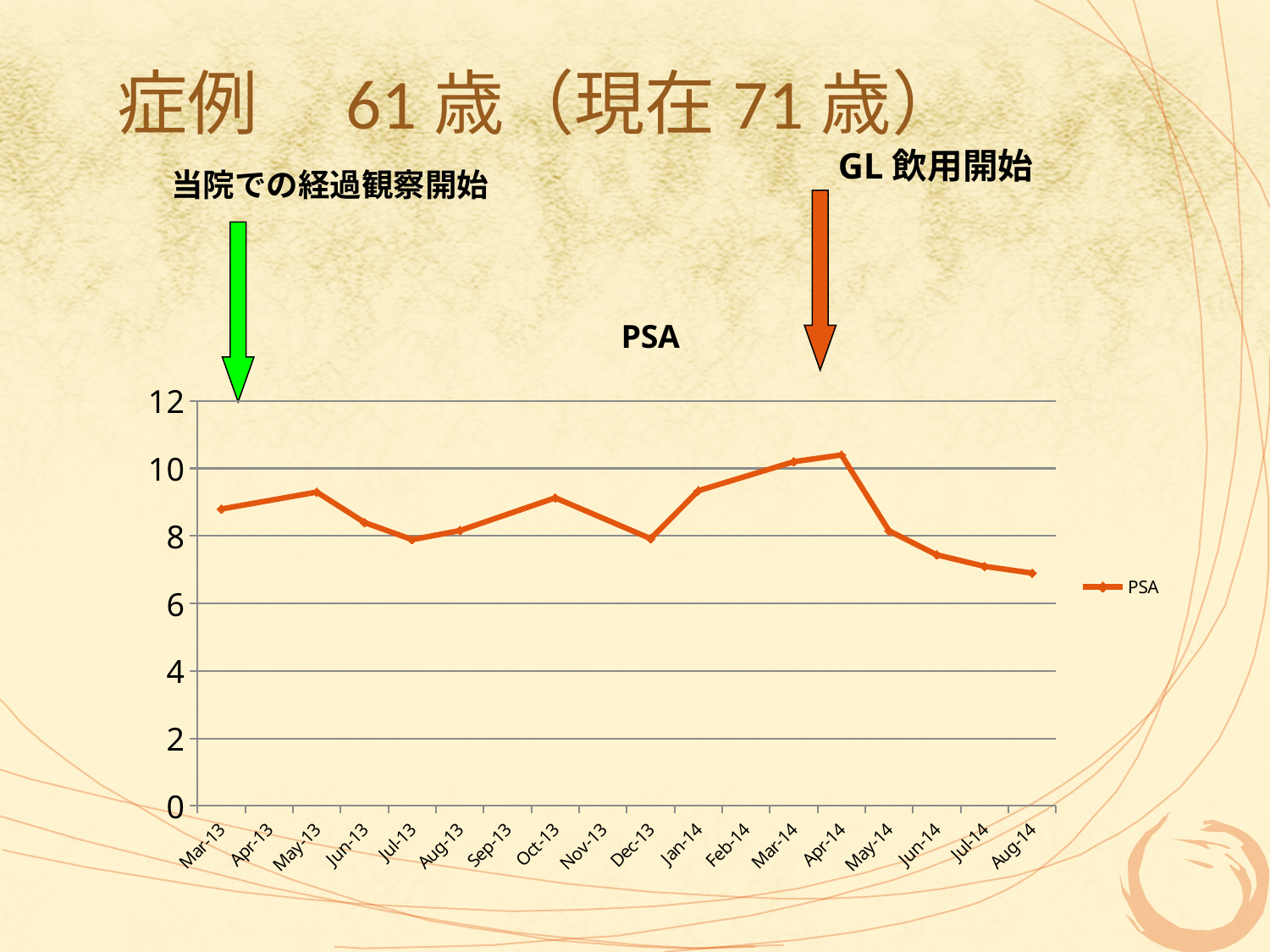
How many series does the legend list? 1 Is the PSA value for Apr-14 greater or less than 10? greater Is the PSA value for Aug-14 greater or less than 8? less Which has the larger PSA value, Jun-13 or Jun-14? Jun-13 What is the title of the chart? PSA How many months are plotted along the x axis? 18 In which month is the PSA value highest? Apr-14 What kind of chart is shown on the slide? line chart Is the PSA value for Jun-14 greater or less than 8? less Which has the larger PSA value, Apr-14 or Aug-14? Apr-14 Do the PSA values rise or fall from Apr-14 to Aug-14? fall